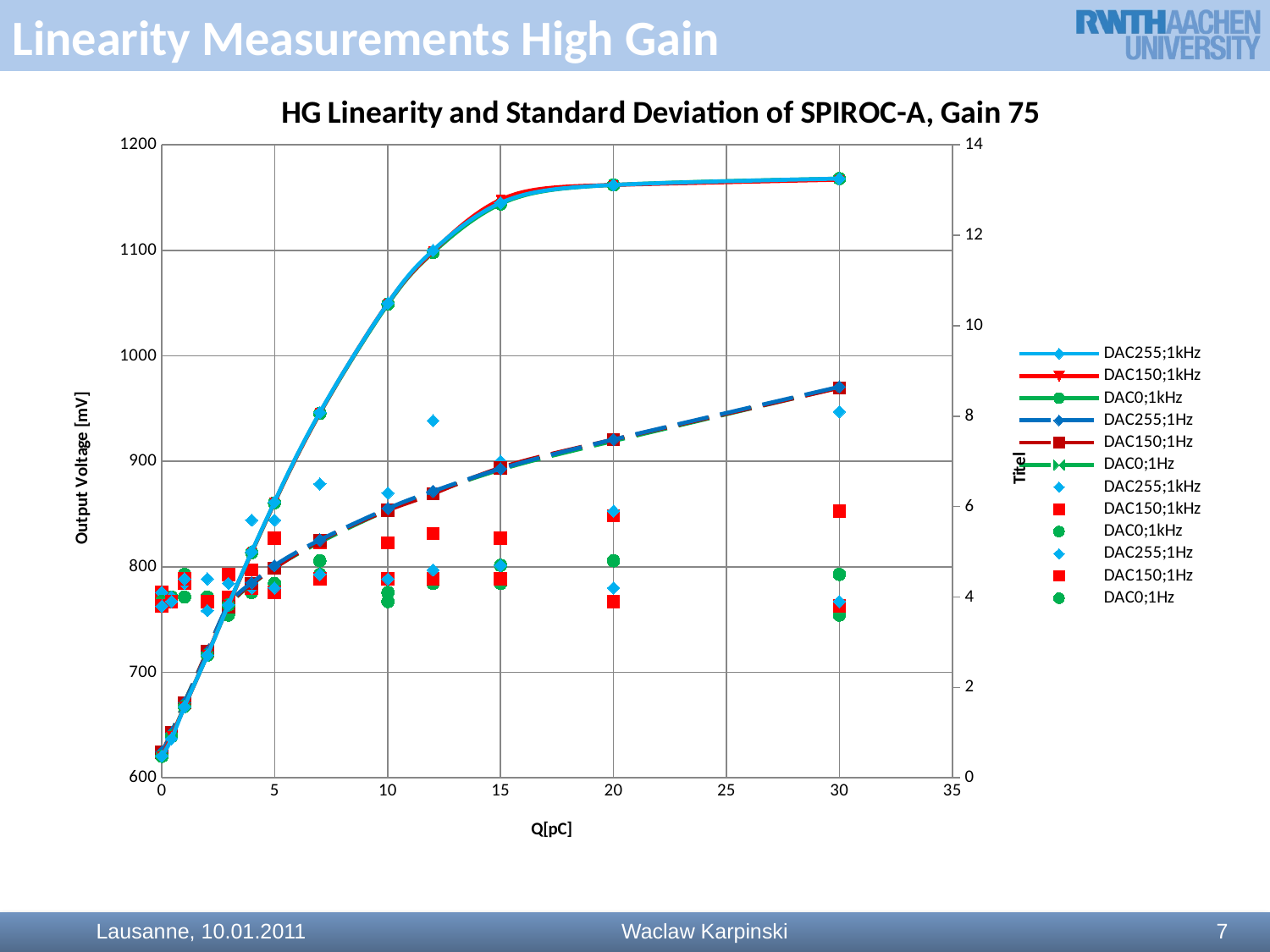
What kind of chart is shown on the slide? line chart What is the title of the chart? HG Linearity and Standard Deviation of SPIROC-A, Gain 75 Is the output voltage of the dashed DAC255;1Hz line at Q = 30 pC greater or less than 1000 mV? less Is the output voltage of the DAC255;1kHz line at Q = 30 pC greater or less than 1100 mV? greater Is the output voltage of the DAC255;1kHz line at Q = 5 pC greater or less than 900 mV? less How many entries does the chart legend list? 12 Does the dashed DAC150;1Hz line rise or fall as Q increases from 0 to 30 pC? rise What is the label of the x axis? Q[pC] At Q = 30 pC, which line has the higher output voltage: the solid DAC255;1kHz line or the dashed DAC255;1Hz line? DAC255;1kHz Does the DAC255;1kHz line rise or fall as Q increases from 0 to 30 pC? rise